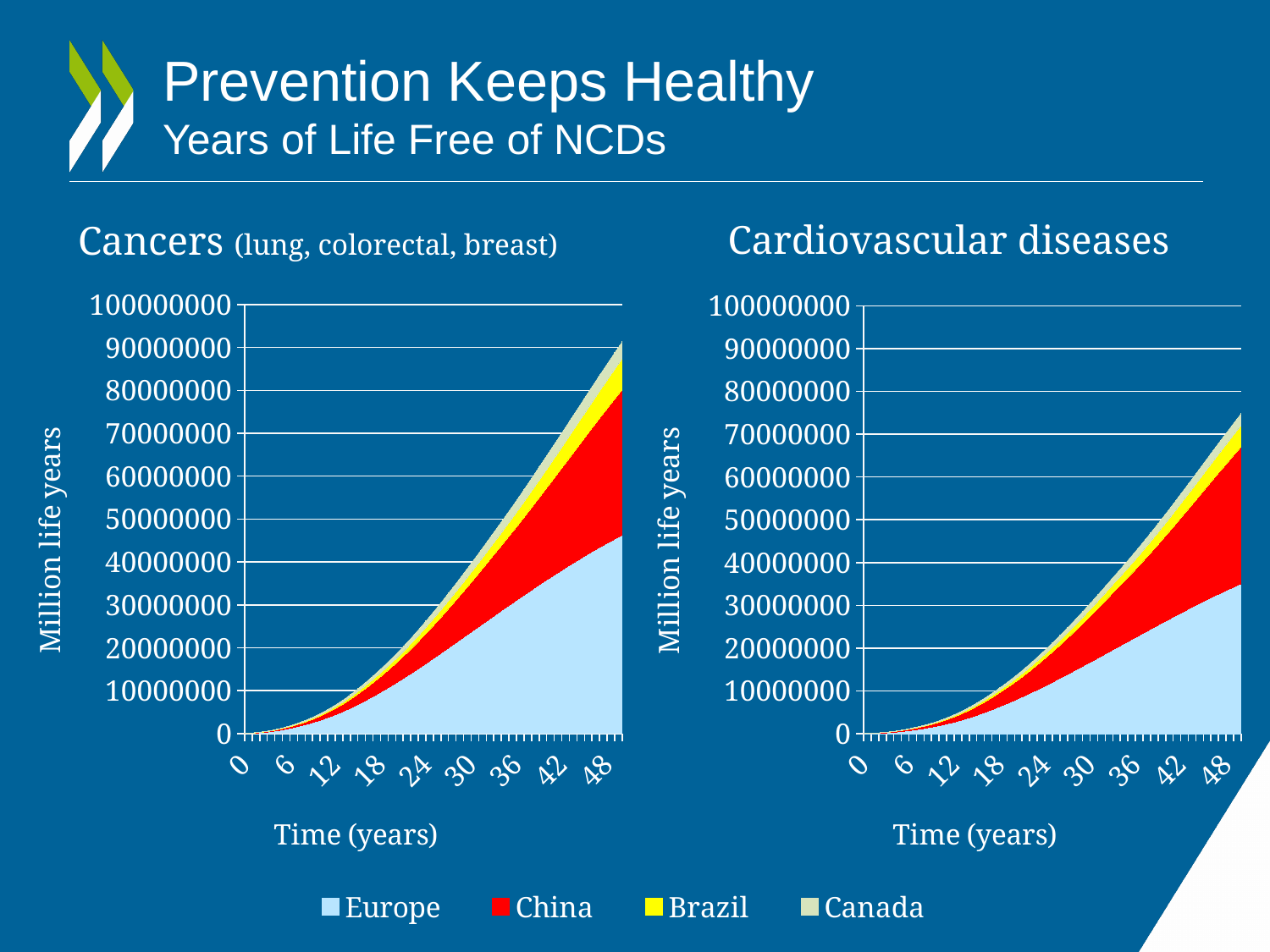
In the Cardiovascular diseases chart, is the total stacked value at the end of the time period greater or less than 60000000? greater How many series does the legend list for the charts? 4 In the Cancers chart, do the stacked values rise or fall as time increases along the x axis? Rise In the Cardiovascular diseases chart, is the value for Europe at the end of the time period greater or less than 40000000? less In the Cancers chart, is the value for Europe at the end of the time period greater or less than 40000000? greater Which series are listed in the legend shared by the two charts? Europe, China, Brazil, Canada In the Cardiovascular diseases chart, which series contributes more at the end of the time period, Brazil or China? China In the Cardiovascular diseases chart, do the stacked values rise or fall as time increases along the x axis? Rise What kind of chart is the Cancers chart on the left? Stacked area chart In the Cancers chart, which series contributes more at the end of the time period, Europe or China? Europe What is the y-axis label on the Cardiovascular diseases chart? Million life years